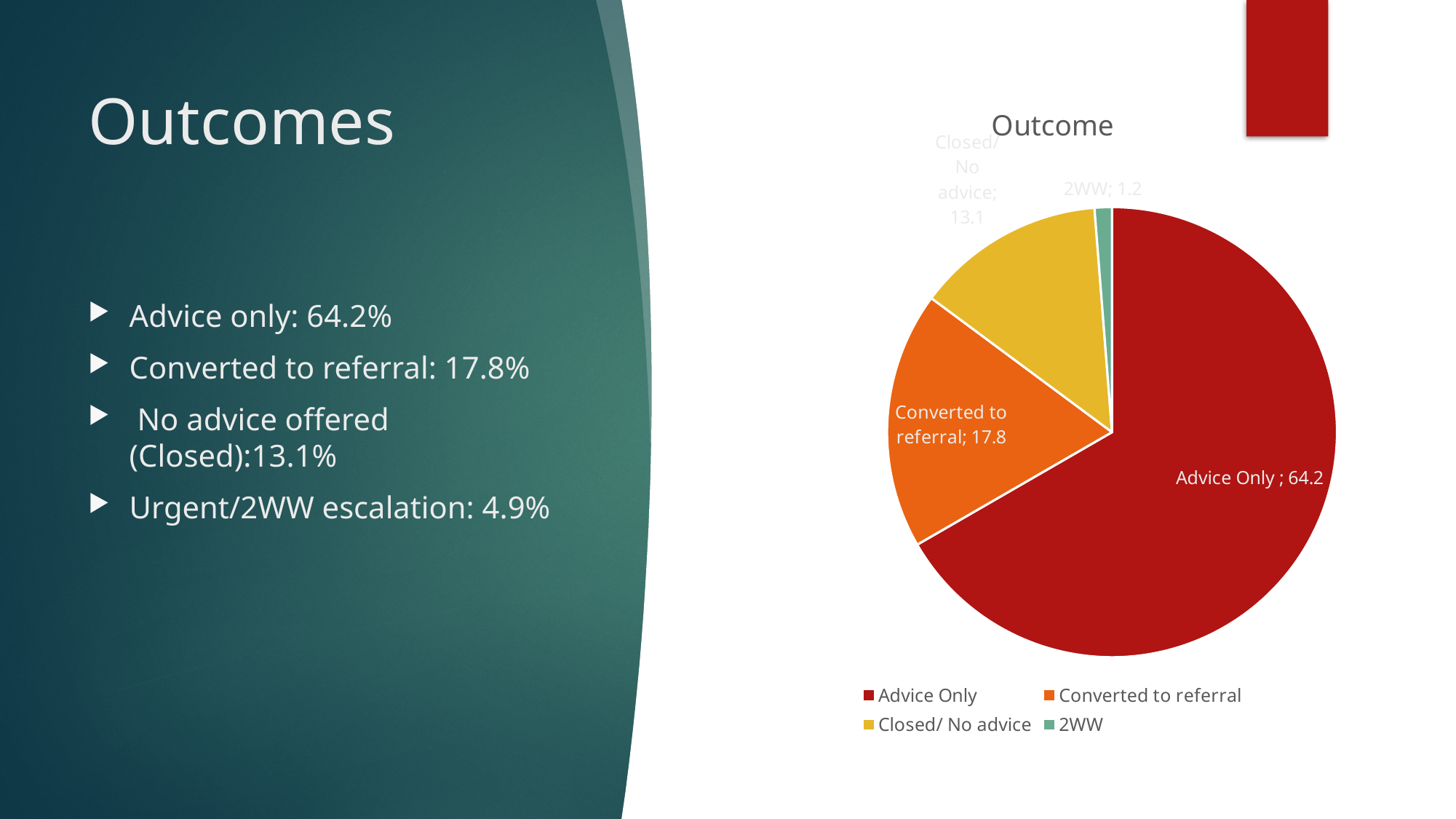
What value is shown for the Advice Only slice? 64.2 How many categories does the pie chart show? 4 Which is larger, the Converted to referral slice or the Closed/ No advice slice? Converted to referral Which category has the smallest slice of the pie? 2WW What value is shown for the Converted to referral slice? 17.8 What is the difference between the Advice Only value and the Converted to referral value? 46.4 What value is shown for the Closed/ No advice slice? 13.1 What type of chart is shown on the slide? pie chart What is the title of the pie chart? Outcome What value is shown for the 2WW slice? 1.2 Which category has the largest slice of the pie? Advice Only What colour is the Advice Only slice in the pie chart? red